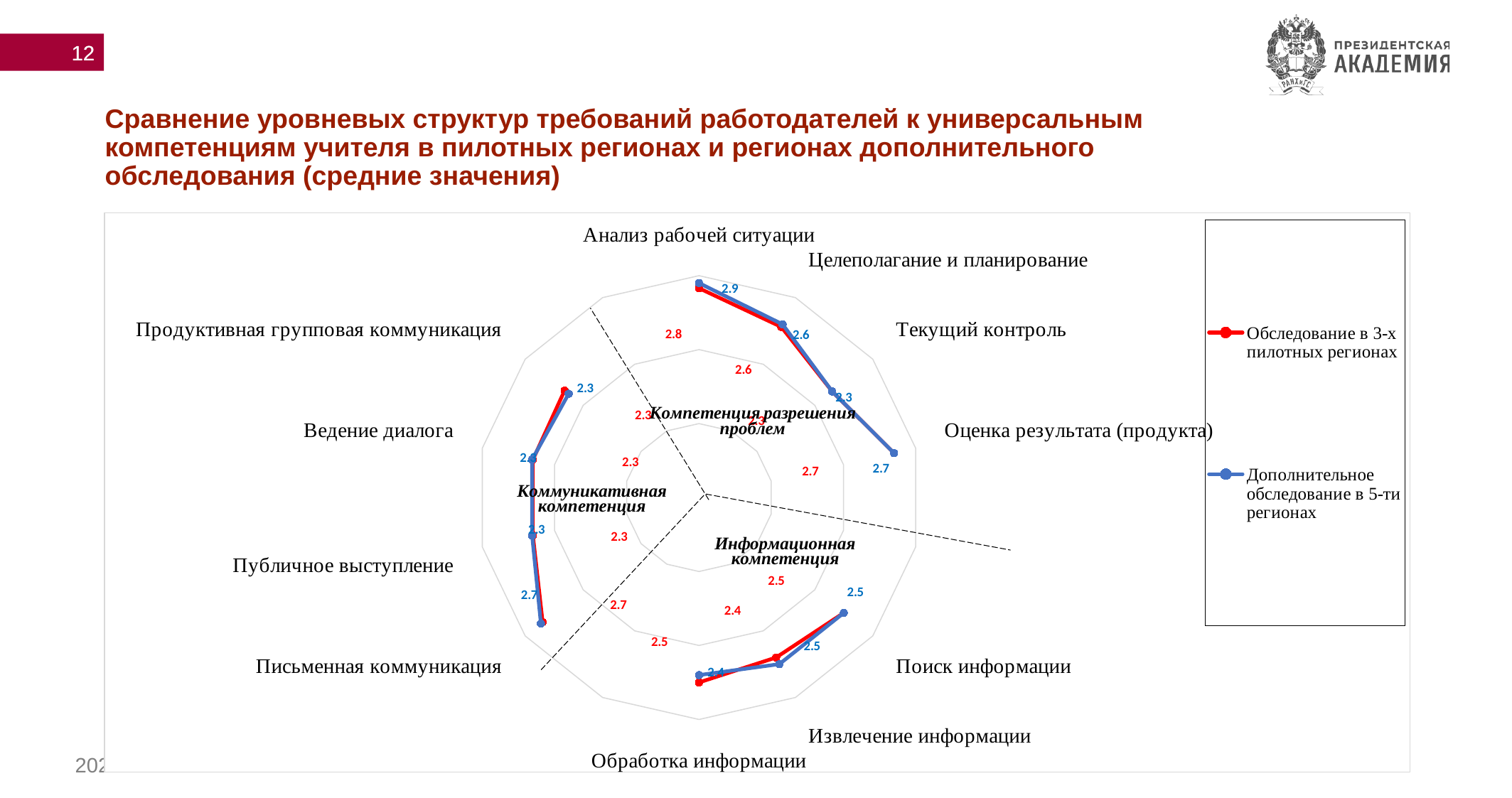
What is the value for Текущий контроль in the series Дополнительное обследование в 5-ти регионах? 2.3 What is the value for Анализ рабочей ситуации in the series Дополнительное обследование в 5-ти регионах? 2.9 What kind of chart is shown on the slide? Radar chart How many series does the legend list? 2 What is the value for Целеполагание и планирование in the series Дополнительное обследование в 5-ти регионах? 2.6 What are the two series named in the legend? Обследование в 3-х пилотных регионах; Дополнительное обследование в 5-ти регионах Which category has the highest value in the series Дополнительное обследование в 5-ти регионах? Анализ рабочей ситуации What is the value for Поиск информации in the series Дополнительное обследование в 5-ти регионах? 2.5 What is the value for Анализ рабочей ситуации in the series Обследование в 3-х пилотных регионах? 2.8 What is the difference between the two series' values for Анализ рабочей ситуации? 0.1 For Анализ рабочей ситуации, which series has the larger value: Обследование в 3-х пилотных регионах or Дополнительное обследование в 5-ти регионах? Дополнительное обследование в 5-ти регионах What is the value for Оценка результата (продукта) in the series Дополнительное обследование в 5-ти регионах? 2.7